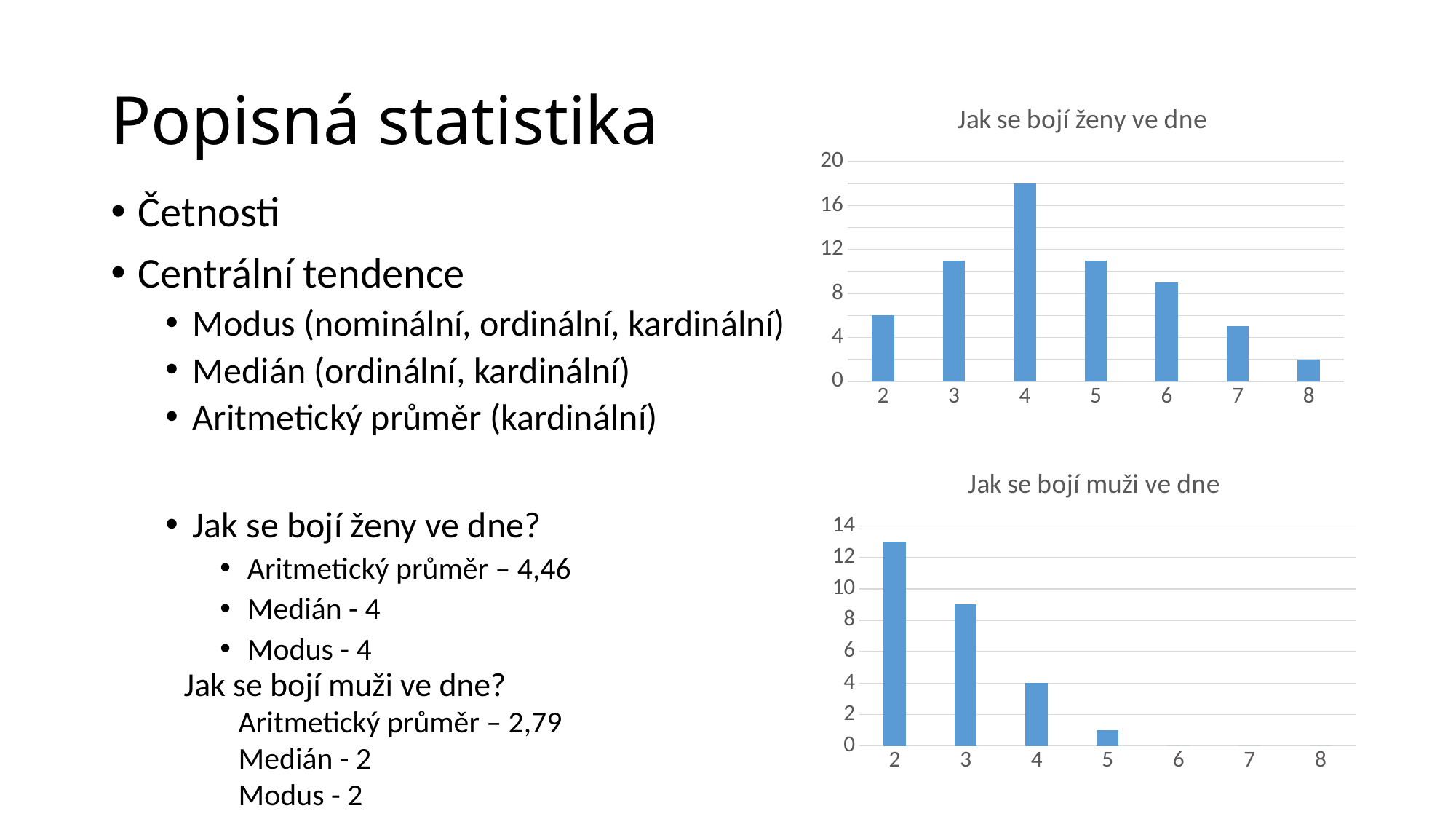
In the top chart "Jak se bojí ženy ve dne", which is larger, the value for category 4 or the value for category 2? 4 In the top chart "Jak se bojí ženy ve dne", is the value for category 4 greater or less than 16? greater In the bottom chart "Jak se bojí muži ve dne", is the value for category 2 greater or less than 12? greater In the top chart "Jak se bojí ženy ve dne", which category has the lowest bar? 8 What is the title of the bottom chart on the slide? Jak se bojí muži ve dne In the bottom chart "Jak se bojí muži ve dne", what is the value for category 4? 4 How many categories are shown on the x axis of the top chart "Jak se bojí ženy ve dne"? 7 In the bottom chart "Jak se bojí muži ve dne", do the values rise or fall as you move from category 2 to category 5 along the x axis? fall In the top chart "Jak se bojí ženy ve dne", which category has the highest bar? 4 What kind of chart is the top chart titled "Jak se bojí ženy ve dne"? bar chart In the top chart "Jak se bojí ženy ve dne", is the value for category 8 greater or less than 4? less In the bottom chart "Jak se bojí muži ve dne", which category has the highest bar? 2